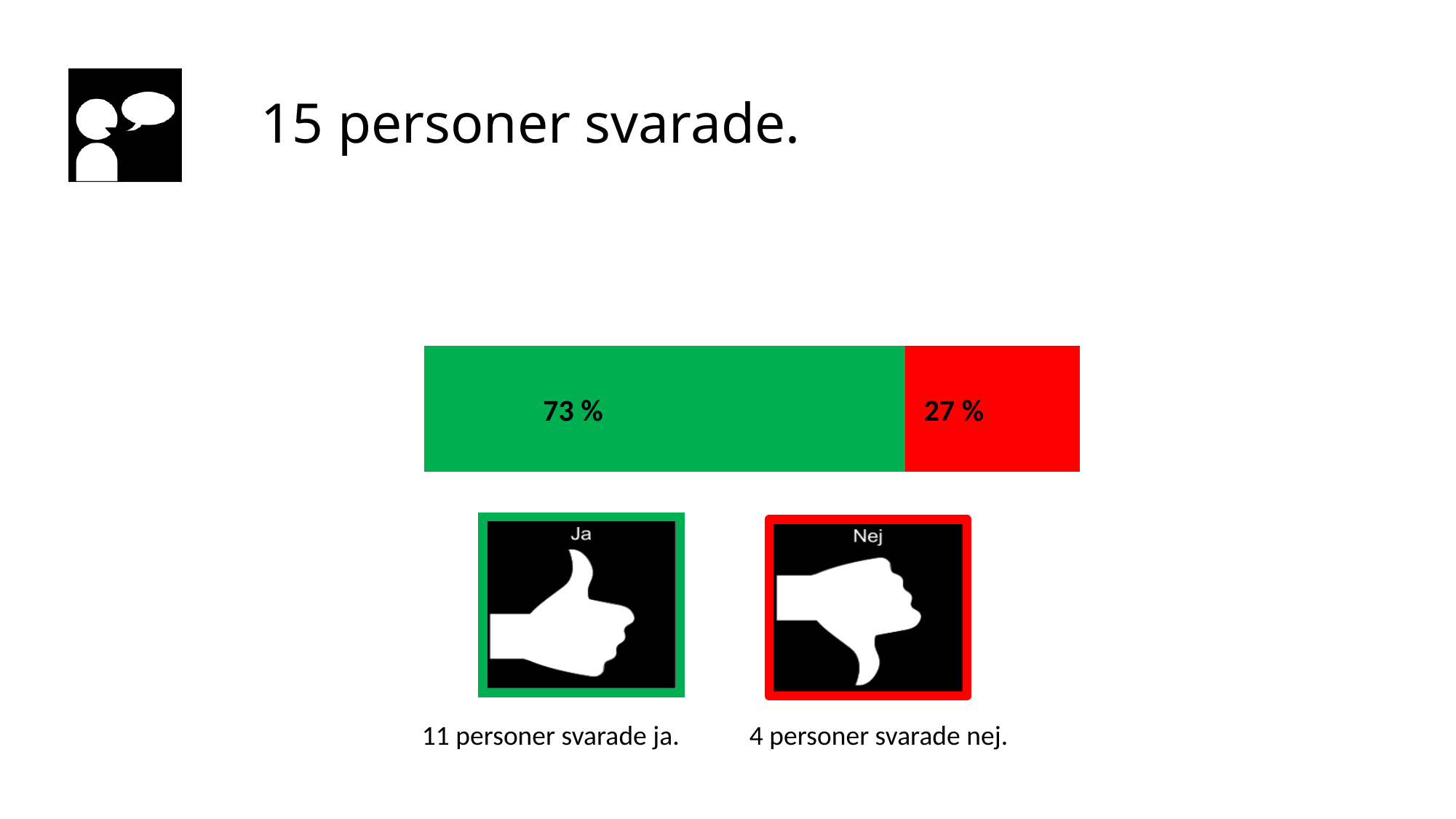
What is the difference in percentage points between the green and red segments? 46 Which answer has the lowest share, 'Ja' or 'Nej'? Nej What share of the bar corresponds to 'Nej'? 27 % What share of the bar corresponds to 'Ja'? 73 % What colour is the segment representing 'Nej'? red What percentage does the green segment of the bar show? 73 % What kind of chart is shown on the slide? stacked bar chart Which answer has the highest share, 'Ja' or 'Nej'? Ja What is the total of the two segments in the stacked bar? 100 % What percentage does the red segment of the bar show? 27 % Which segment of the bar is larger, the green one or the red one? green How many segments does the bar have? 2